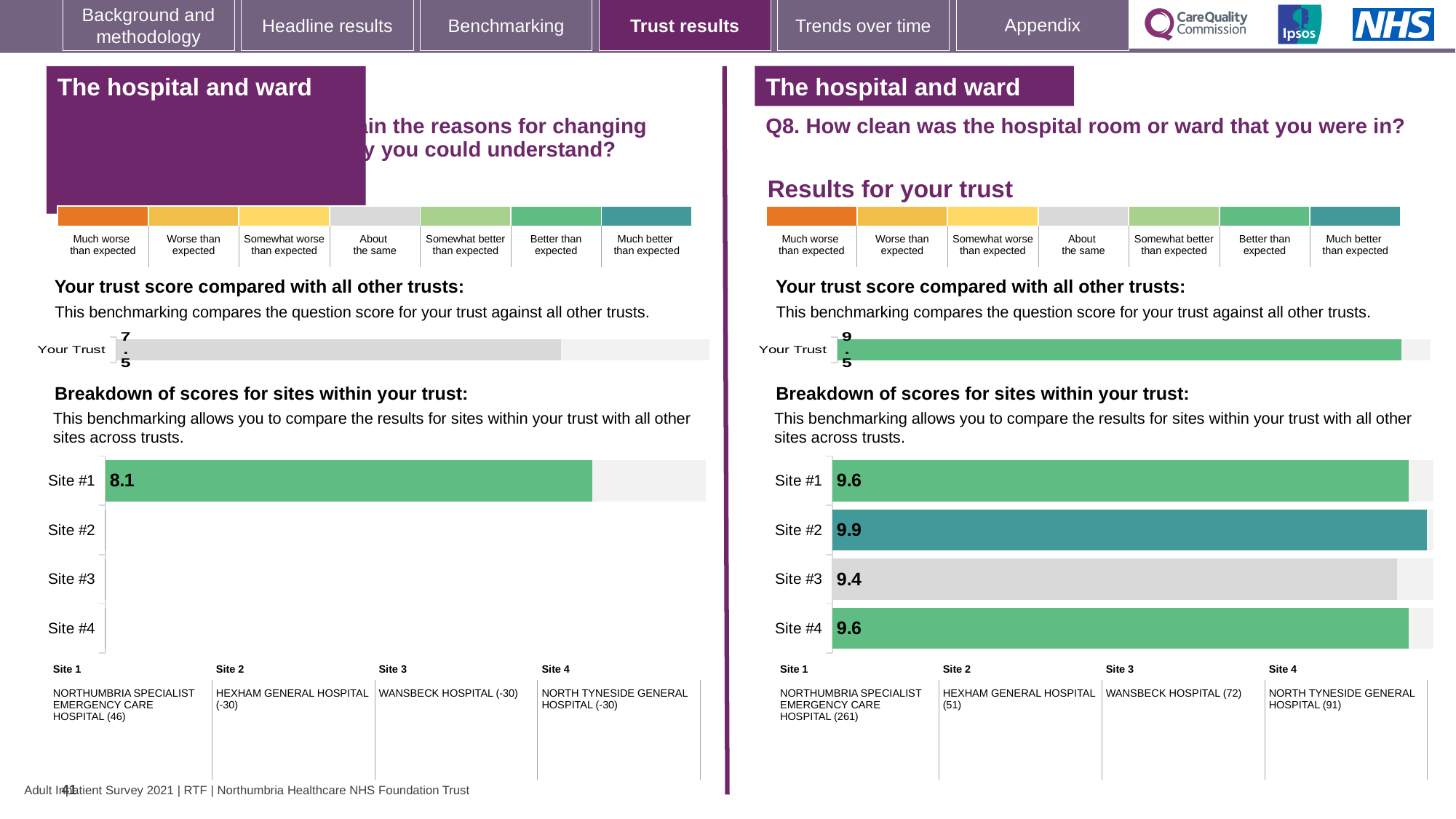
On the right-hand chart for Q8, what is the score for Site #3? 9.4 What kind of chart is used for the breakdown of scores for sites on the right-hand side? Bar chart On the right-hand chart for Q8, which site has the highest score? Site #2 On the right-hand chart for Q8, which site has the lowest score? Site #3 On the right-hand chart for Q8, how many sites are listed in the breakdown of scores? 4 On the right-hand chart for Q8, what is the difference between the scores for Site #2 and Site #3? 0.5 On the right-hand chart for Q8, what colour is the bar for Site #3? Grey On the right-hand chart for Q8, which has the larger score, Site #1 or Site #3? Site #1 On the right-hand side for Q8, what is the 'Your Trust' score compared with all other trusts? 9.5 On the left-hand side, what is the 'Your Trust' score compared with all other trusts? 7.5 On the right-hand chart for Q8 (How clean was the hospital room or ward), what is the score for Site #2? 9.9 On the left-hand chart (breakdown of scores for sites), what is the score for Site #1? 8.1